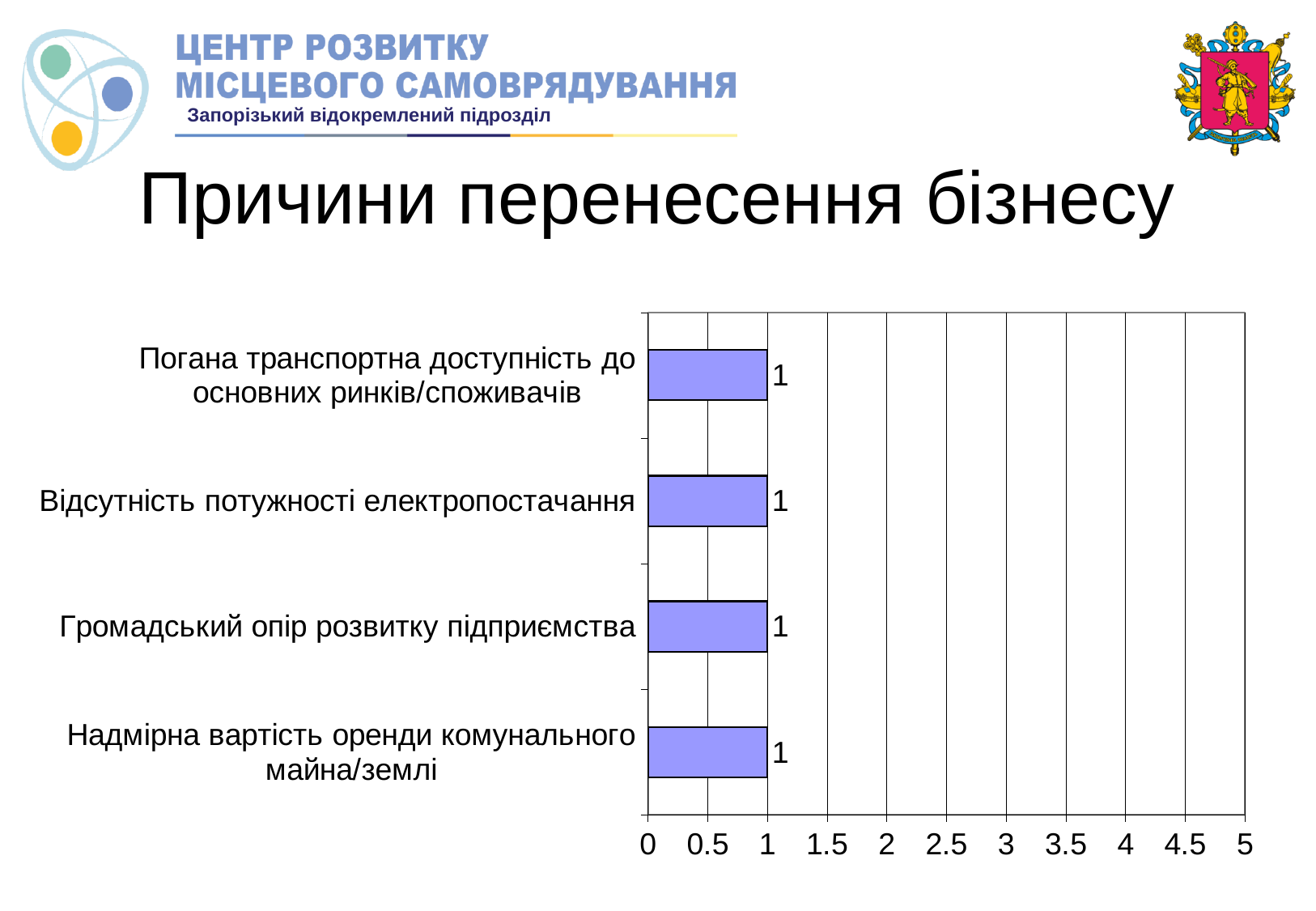
What is the value for "Відсутність потужності електропостачання"? 1 How many categories are shown in the chart? 4 What is the value for "Громадський опір розвитку підприємства"? 1 Is the value for "Надмірна вартість оренди комунального майна/землі" greater or less than 2? less Is the value for "Погана транспортна доступність до основних ринків/споживачів" greater or less than 0.5? greater What is the value for "Надмірна вартість оренди комунального майна/землі"? 1 What type of chart is shown on the slide? bar chart What is the difference between the values for "Громадський опір розвитку підприємства" and "Відсутність потужності електропостачання"? 0 What is the title of the slide containing the chart? Причини перенесення бізнесу What is the maximum value shown on the horizontal axis of the chart? 5 What is the value for "Погана транспортна доступність до основних ринків/споживачів"? 1